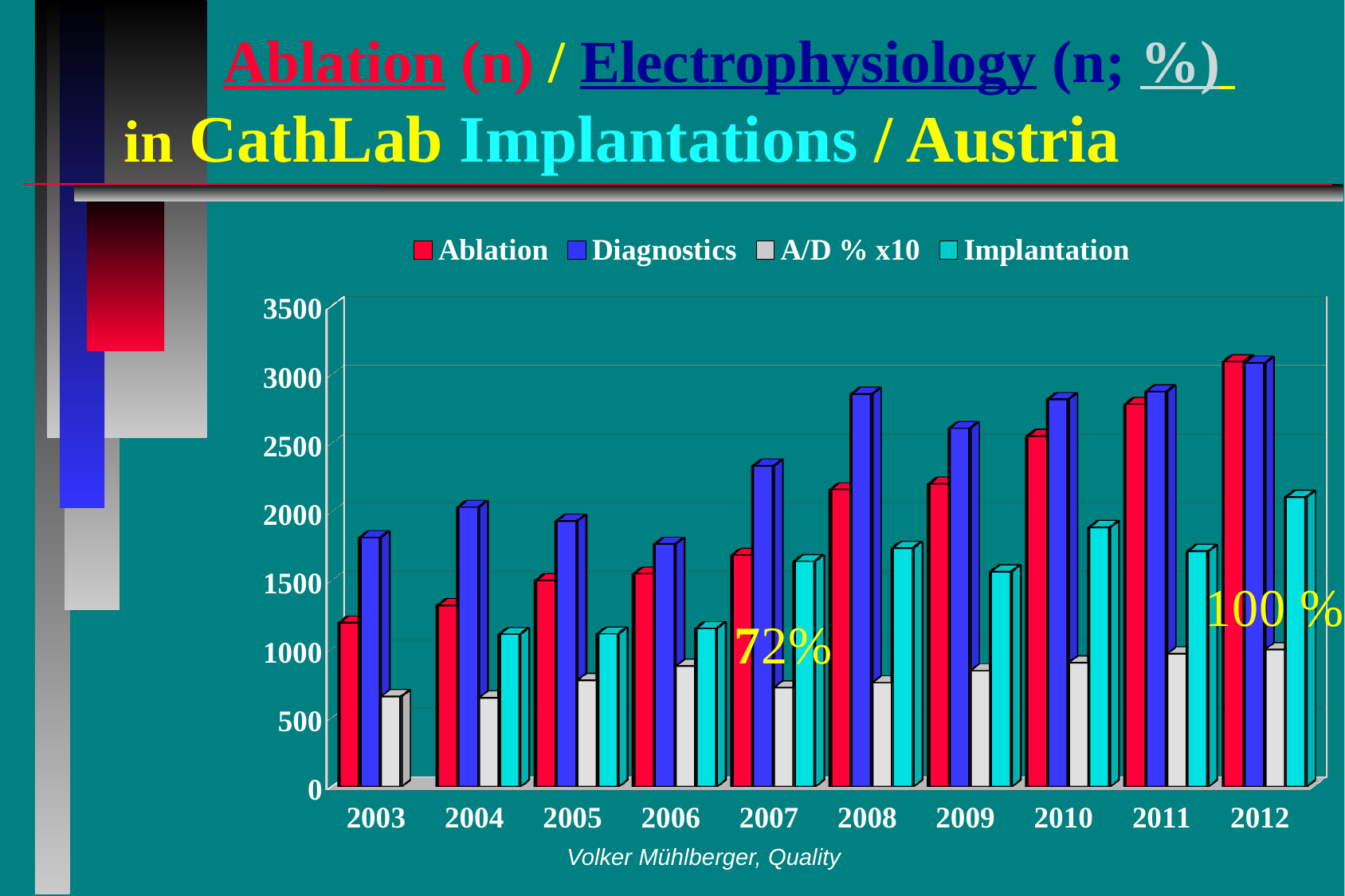
Is the Ablation value for 2003 greater or less than 1500? less What kind of chart is shown on the slide? bar chart In which year is the Implantation bar highest? 2012 Do the Ablation values generally rise or fall from 2003 to 2012? rise In which year is the Ablation bar lowest? 2003 Is the Diagnostics value for 2008 greater or less than 2500? greater In 2008, which is larger: the Ablation bar or the Diagnostics bar? Diagnostics How many years are shown on the x axis? 10 What percentage annotation is printed next to the 2012 bars? 100 % Is the Implantation value for 2010 greater or less than 1500? greater How many series does the legend list? 4 In which year is the Ablation bar highest? 2012